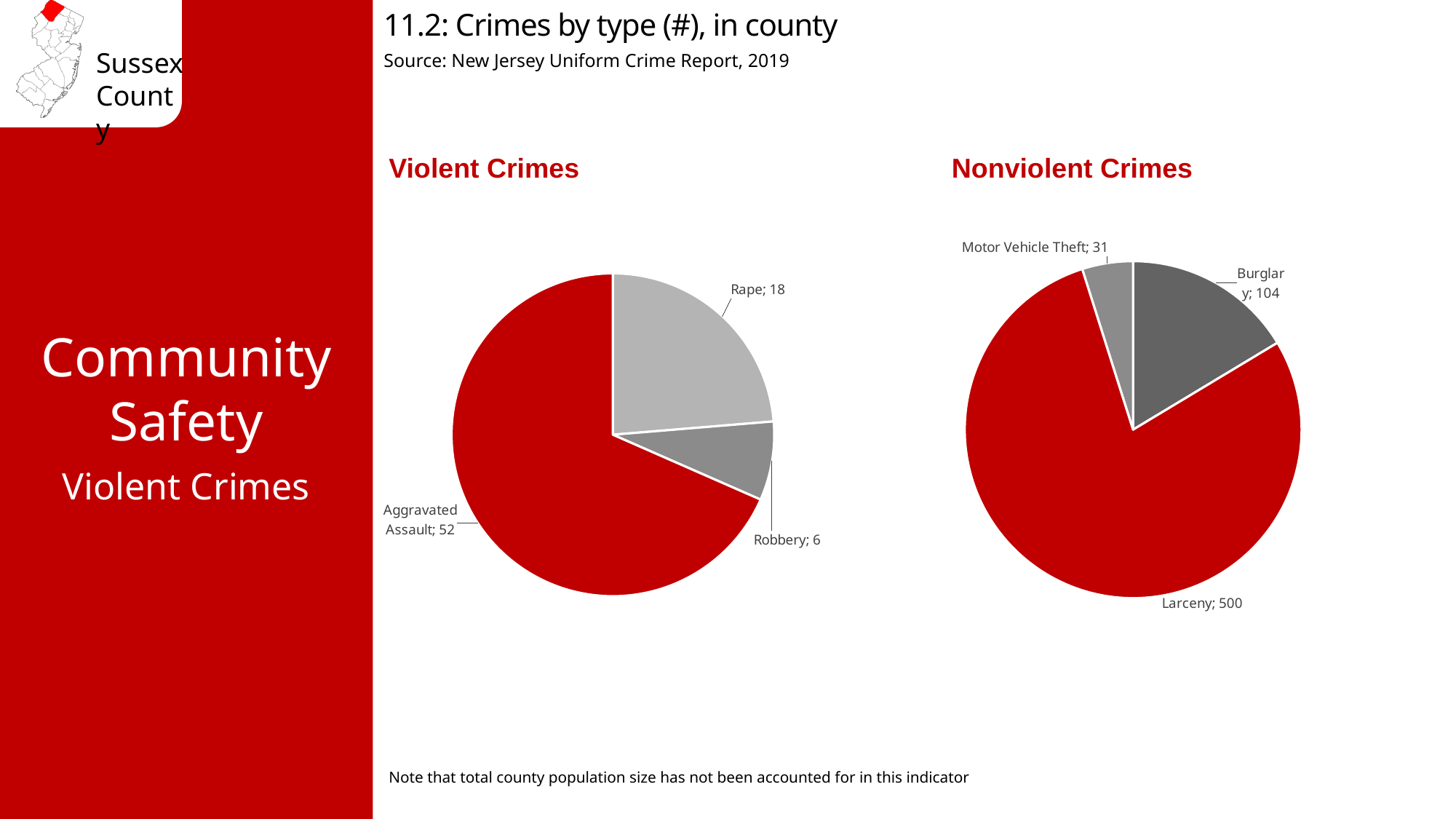
In the Nonviolent Crimes chart, which crime type has the smallest slice? Motor Vehicle Theft In the Violent Crimes chart, which crime type has the largest slice? Aggravated Assault What type of chart is used for Nonviolent Crimes? Pie chart In the Nonviolent Crimes chart, what is the value for Burglary? 104 In the Nonviolent Crimes chart, which is larger, Burglary or Motor Vehicle Theft? Burglary In the Violent Crimes chart, how many aggravated assaults are shown? 52 In the Violent Crimes chart, what is the difference between Rape and Robbery? 12 In the Violent Crimes chart, what is the value for Robbery? 6 What is the total number of violent crimes shown in the Violent Crimes chart? 76 How many crime types are shown in the Violent Crimes chart? 3 In the Nonviolent Crimes chart, how much larger is Larceny than Burglary? 396 In the Nonviolent Crimes chart, what is the value for Motor Vehicle Theft? 31